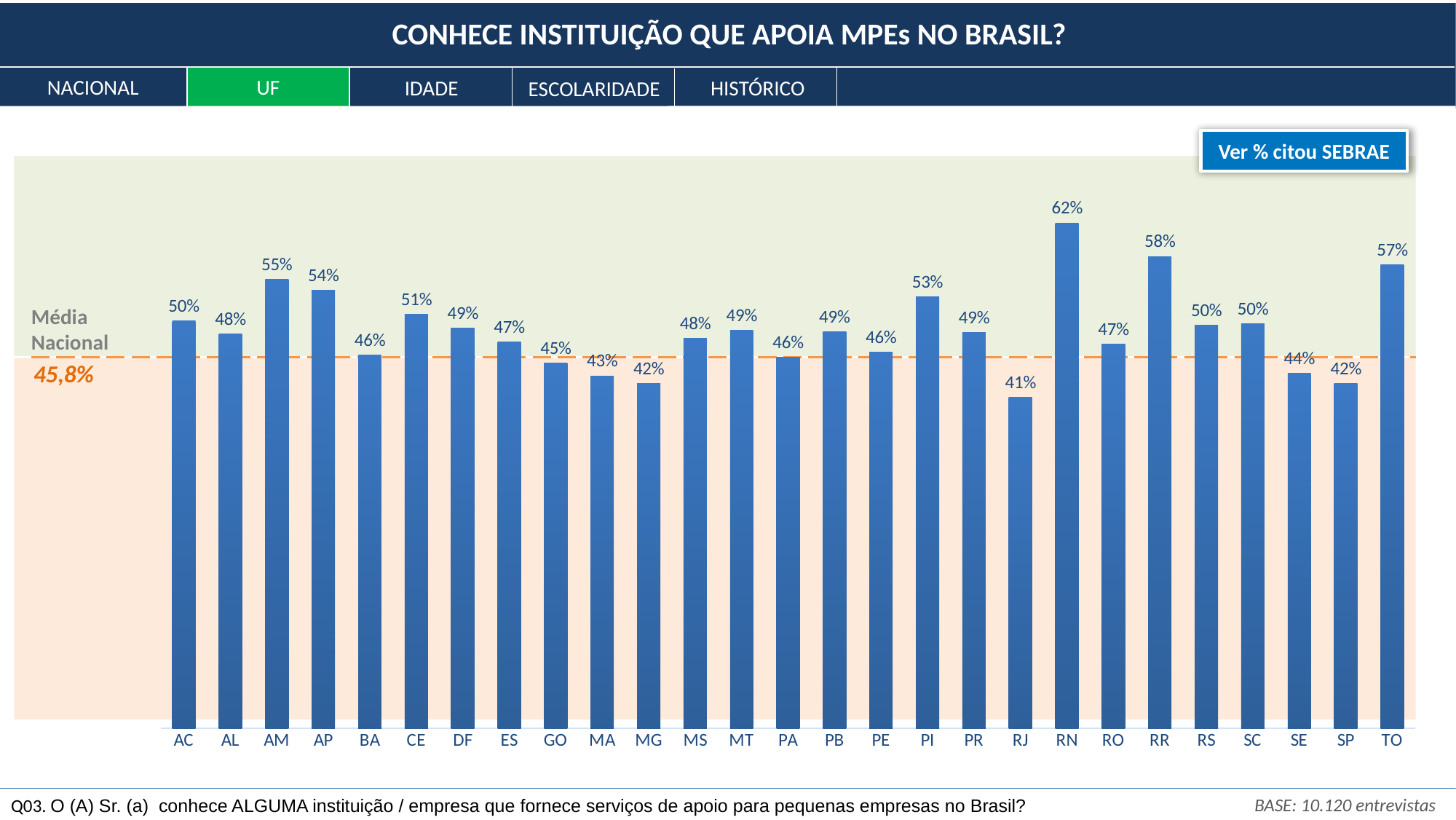
Which state (UF) has the highest value? RN What is the difference between the values for RN and RJ? 21% Which is larger, the value for RR or the value for TO? RR How many states (UFs) are shown on the x axis? 27 What is the value of the 'Média Nacional' reference line shown on the chart? 45,8% Which is larger, the value for MA or the value for CE? CE Which state (UF) has the lowest value? RJ What is the value for PI? 53% What kind of chart is shown on the slide? Bar chart What is the difference between the values for AM and BA? 9% What is the value for SP? 42% What is the value for RN? 62%